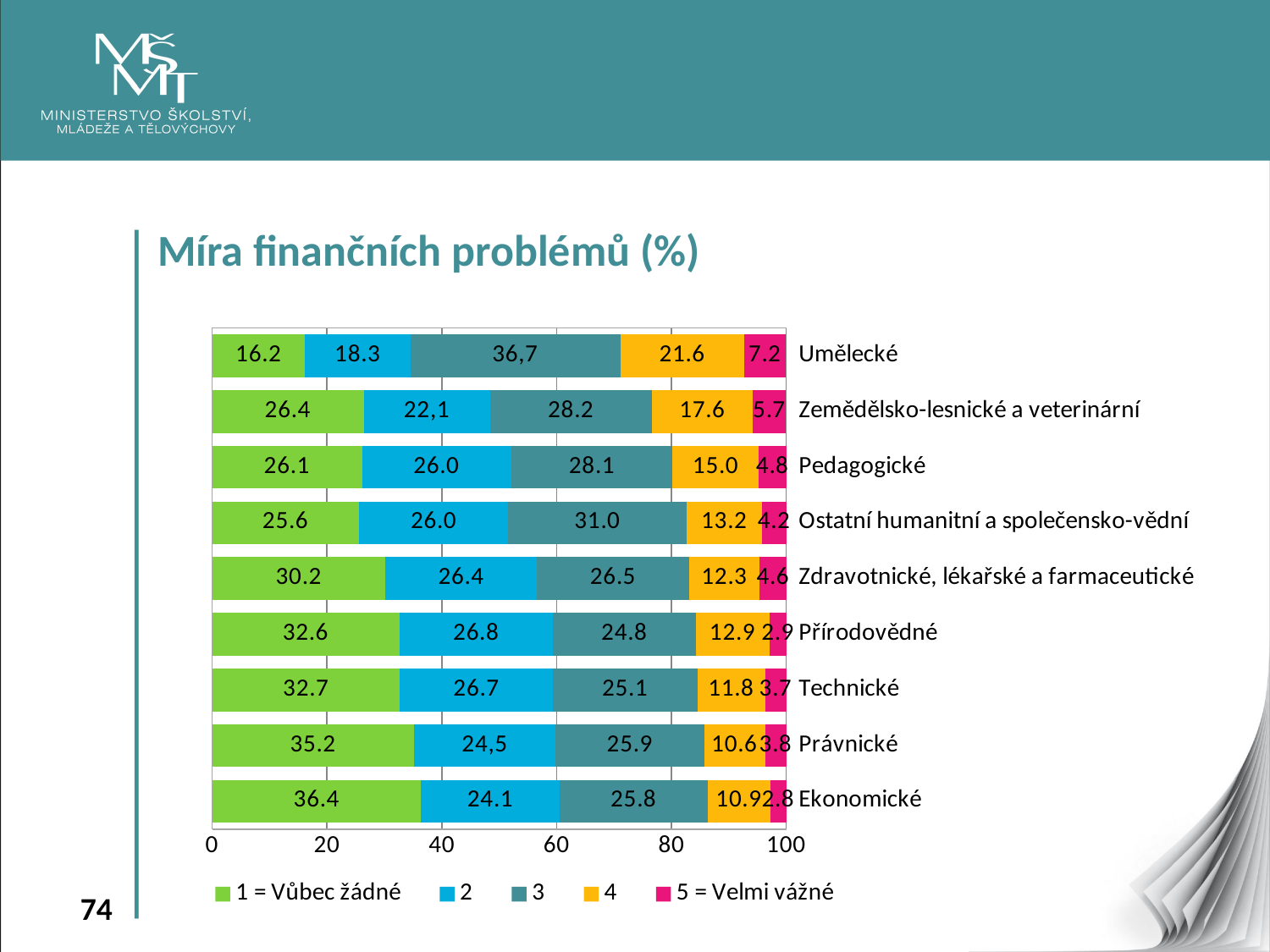
How many series does the legend list? 5 What is the value of series '4' for Zemědělsko-lesnické a veterinární? 17.6 What is the value of series '1 = Vůbec žádné' for Ekonomické? 36.4 What is the value of series '5 = Velmi vážné' for Umělecké? 7.2 What is the value of series '3' for Ostatní humanitní a společensko-vědní? 31.0 How many categories (fields of study) are shown in the chart? 9 What kind of chart is shown on the slide? stacked bar chart What is the difference between the series '4' values for Umělecké and Pedagogické? 6.6 Which is larger: the series '2' value for Přírodovědné or for Technické? Přírodovědné Which category has the lowest value for series '1 = Vůbec žádné'? Umělecké What is the title of the chart? Míra finančních problémů (%) Which category has the highest value for series '1 = Vůbec žádné'? Ekonomické